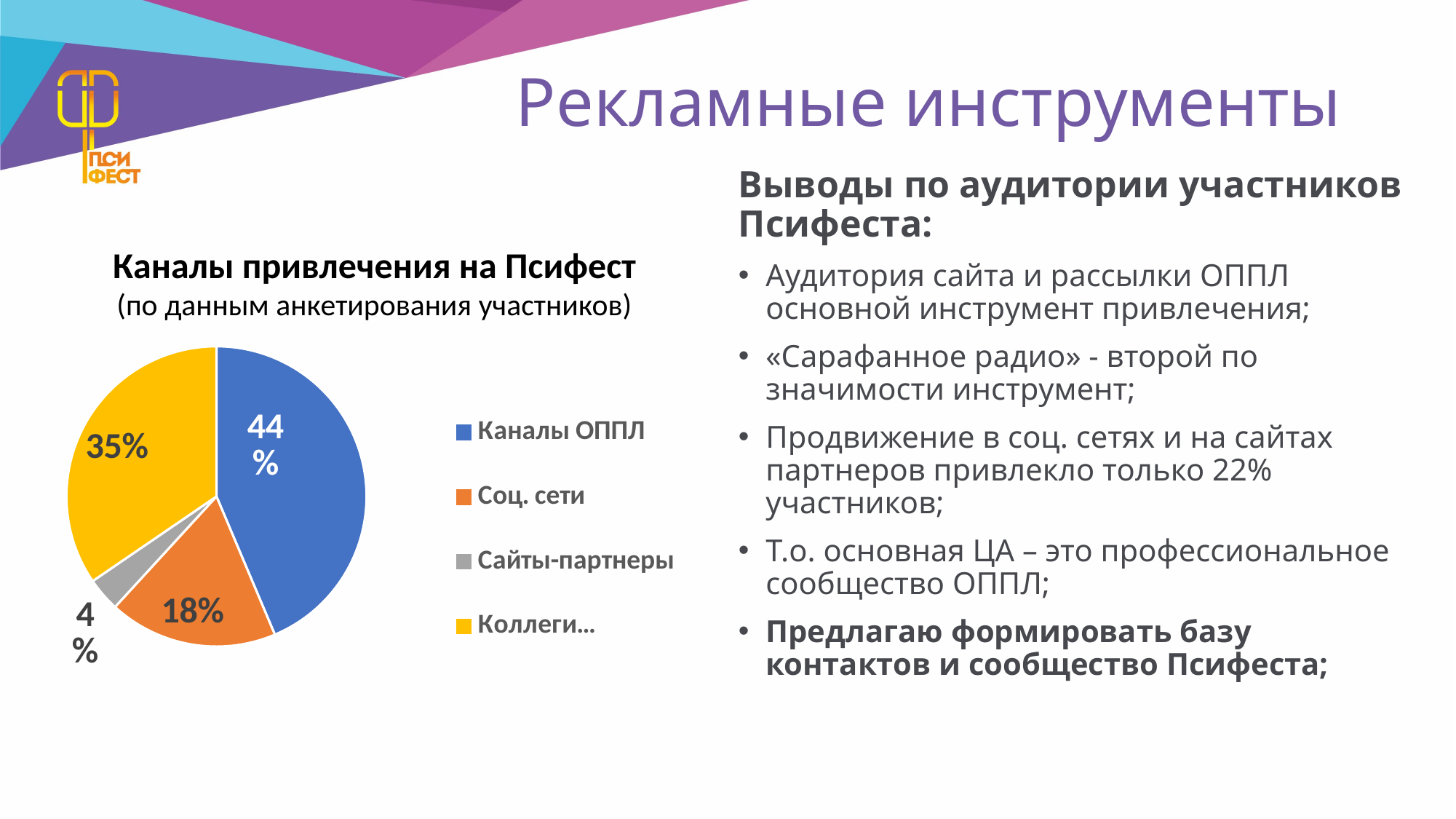
Which category has the largest slice of the pie? Каналы ОППЛ What share of the pie does Каналы ОППЛ have? 44% How many categories does the pie chart have? 4 What share of the pie does Сайты-партнеры have? 4% What kind of chart is shown on the slide? pie chart What is the difference between the shares of Каналы ОППЛ and Коллеги…? 9% Which is larger, the share of Соц. сети or the share of Коллеги…? Коллеги… Which category has the smallest slice of the pie? Сайты-партнеры What share of the pie does Коллеги… have? 35% What colour is the slice for Соц. сети? orange What is the title of the pie chart? Каналы привлечения на Псифест